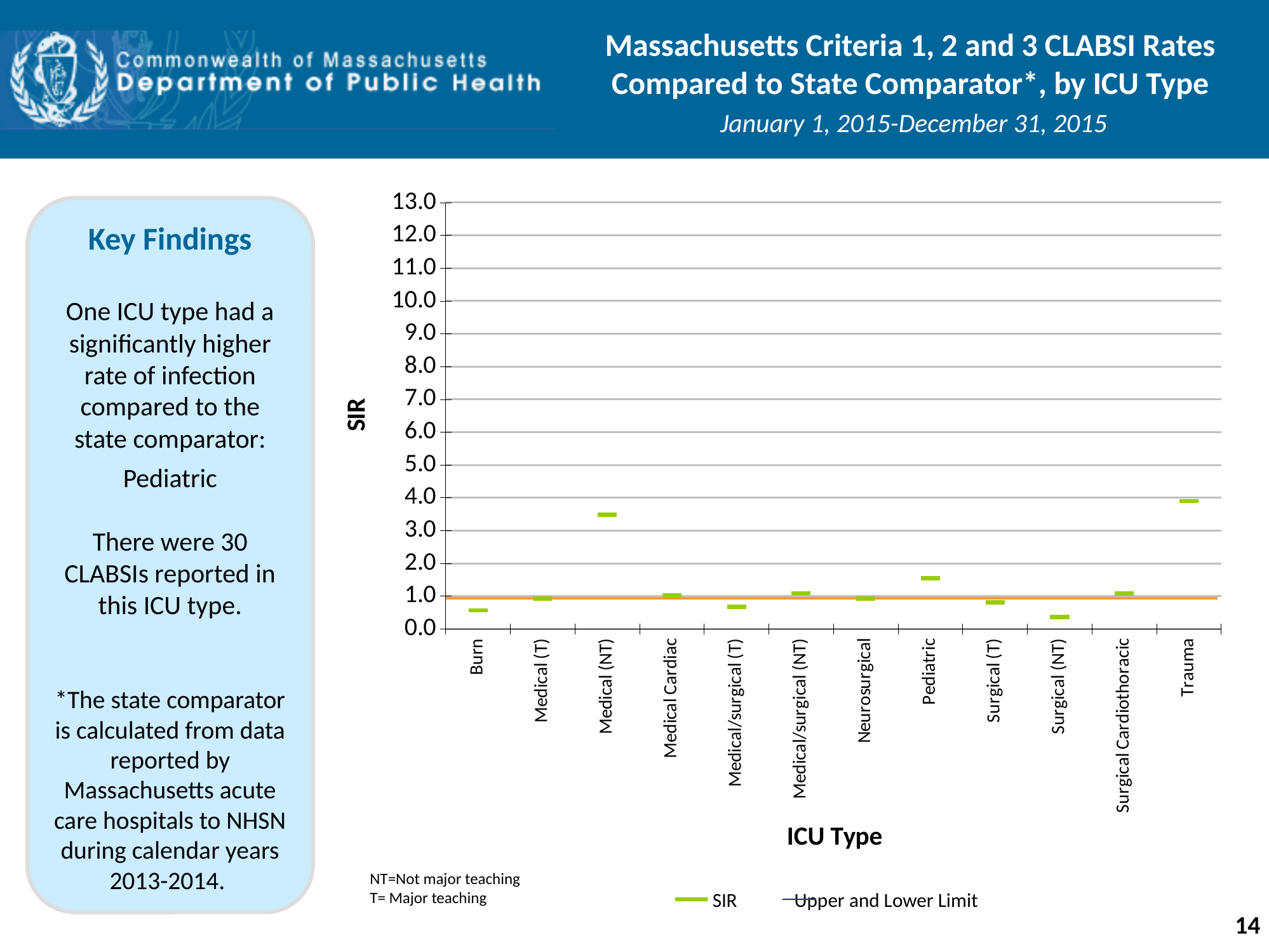
Is the SIR value for Medical (NT) greater or less than 3.0? greater How many series does the chart legend list? 2 What is the title of the chart's y axis? SIR Is the SIR value for Burn greater or less than 1.0? less Which has a higher SIR value, Pediatric or Burn? Pediatric Is the SIR value for Pediatric greater or less than 1.0? greater Which ICU type has the lowest SIR value on the chart? Surgical (NT) How many ICU types are shown on the x axis of the chart? 12 Which has a higher SIR value, Trauma or Medical (NT)? Trauma Which ICU type has the highest SIR value on the chart? Trauma